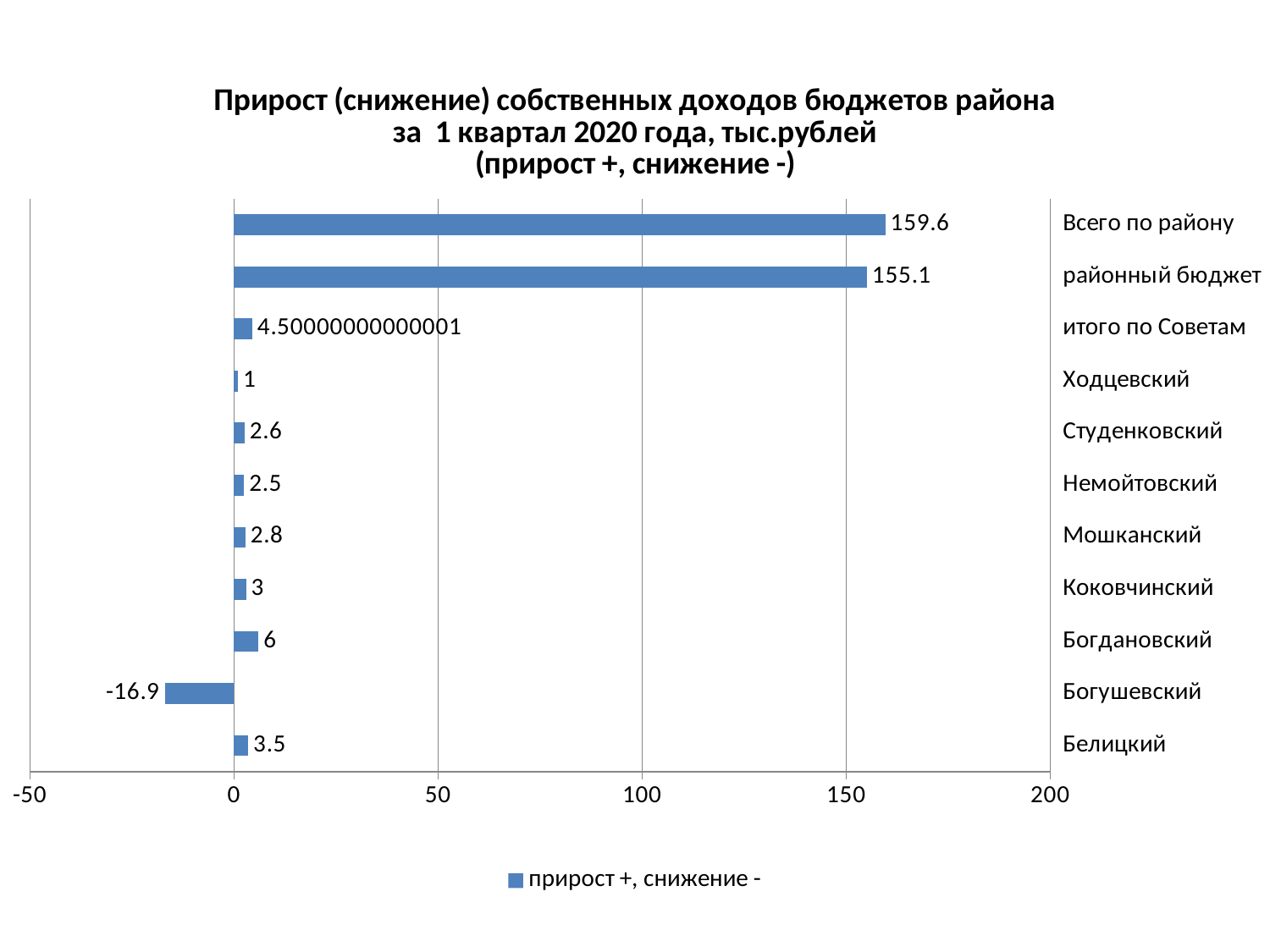
Which category has the highest value? Всего по району How many series does the legend list? 1 Which is larger, the value for Богдановский or the value for Белицкий? Богдановский What kind of chart is shown on the slide? Bar chart What is the difference between the values for Всего по району and районный бюджет? 4.5 What is the value for Богдановский? 6 Is the value for районный бюджет greater or less than 150? greater What is the value for Богушевский? -16.9 What is the value for районный бюджет? 155.1 What is the value for Всего по району? 159.6 How many categories are shown in the chart? 11 Which category has the lowest value? Богушевский